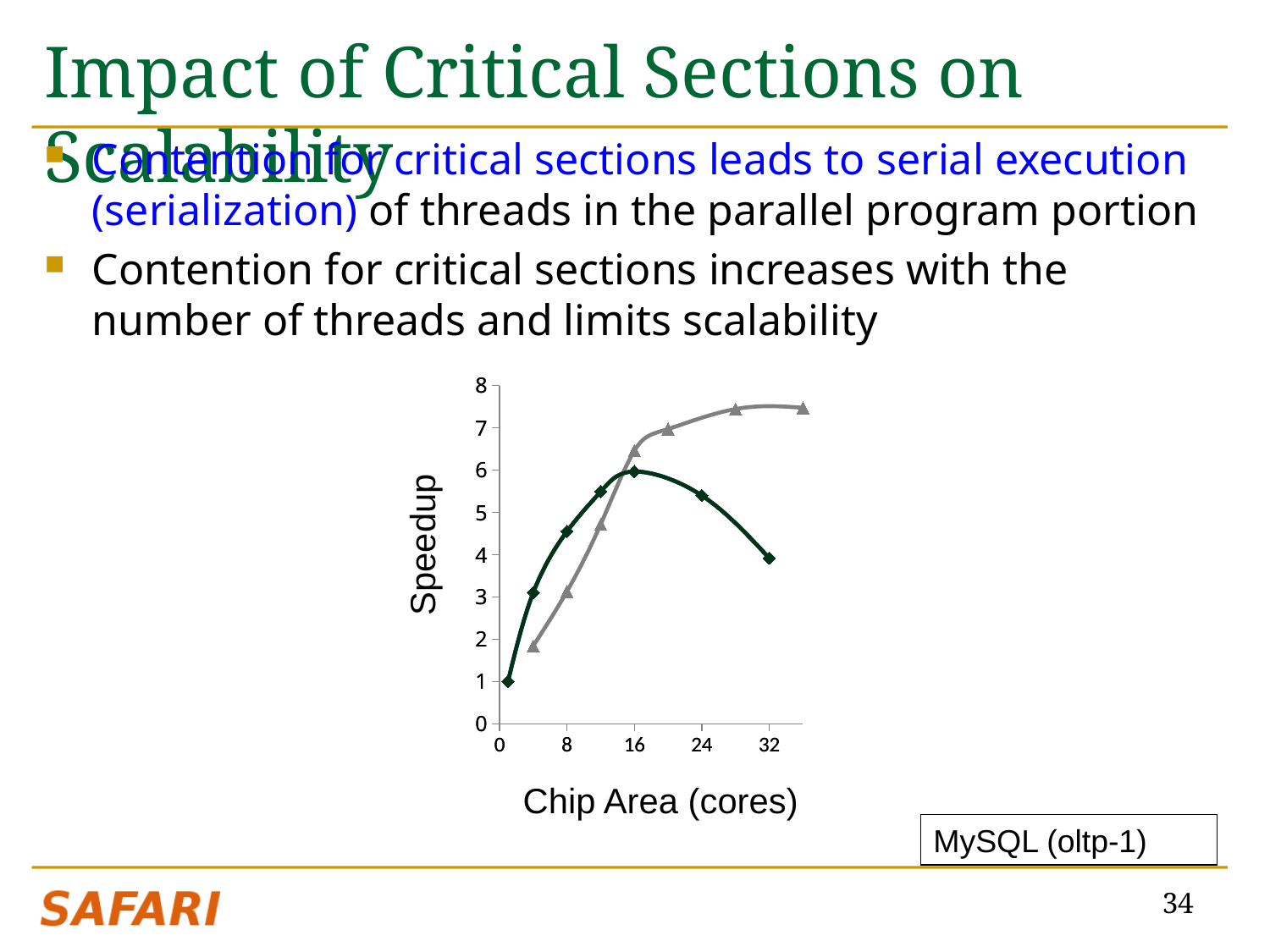
At 32 cores, which line has the higher speedup, the dark green (diamond) line or the gray (triangle) line? the gray (triangle) line Is the speedup of the dark green (diamond) line at 8 cores greater or less than 4? greater What is the label of the x axis of the chart? Chip Area (cores) Is the speedup of the gray (triangle) line at 24 cores greater or less than 6? greater Is the speedup of the dark green (diamond) line at 32 cores greater or less than 5? less At which chip area (cores) does the dark green (diamond) line reach its highest speedup? 16 What is the label of the y axis of the chart? Speedup Does the speedup of the dark green (diamond) line rise or fall as chip area increases from 16 to 32 cores? fall What kind of chart is shown on the slide? line chart At 8 cores, which line has the higher speedup, the dark green (diamond) line or the gray (triangle) line? the dark green (diamond) line